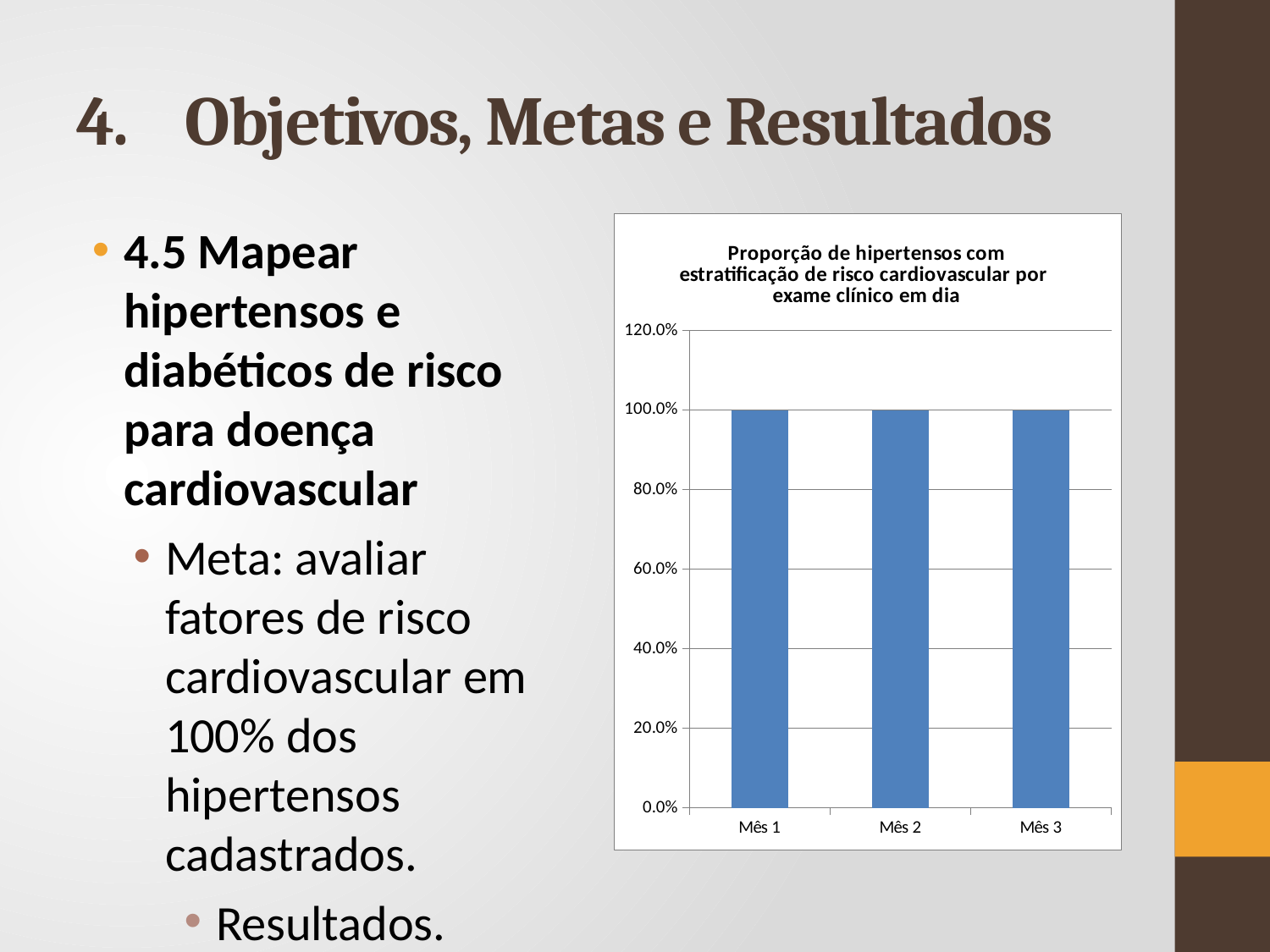
What is the value for Mês 2? 100.0% What is the value for Mês 1? 100.0% What is the label of the first category on the x axis? Mês 1 What is the difference between the values for Mês 1 and Mês 2? 0.0% Is the value for Mês 1 greater or less than 80.0%? greater Is the value for Mês 3 greater or less than 120.0%? less Do the values rise, fall, or stay flat from Mês 1 to Mês 3? stay flat What is the title of the chart? Proporção de hipertensos com estratificação de risco cardiovascular por exame clínico em dia What is the highest value shown on the y axis of the chart? 120.0% What is the value for Mês 3? 100.0% What kind of chart is shown on the slide? bar chart How many categories are plotted on the x axis of the chart? 3